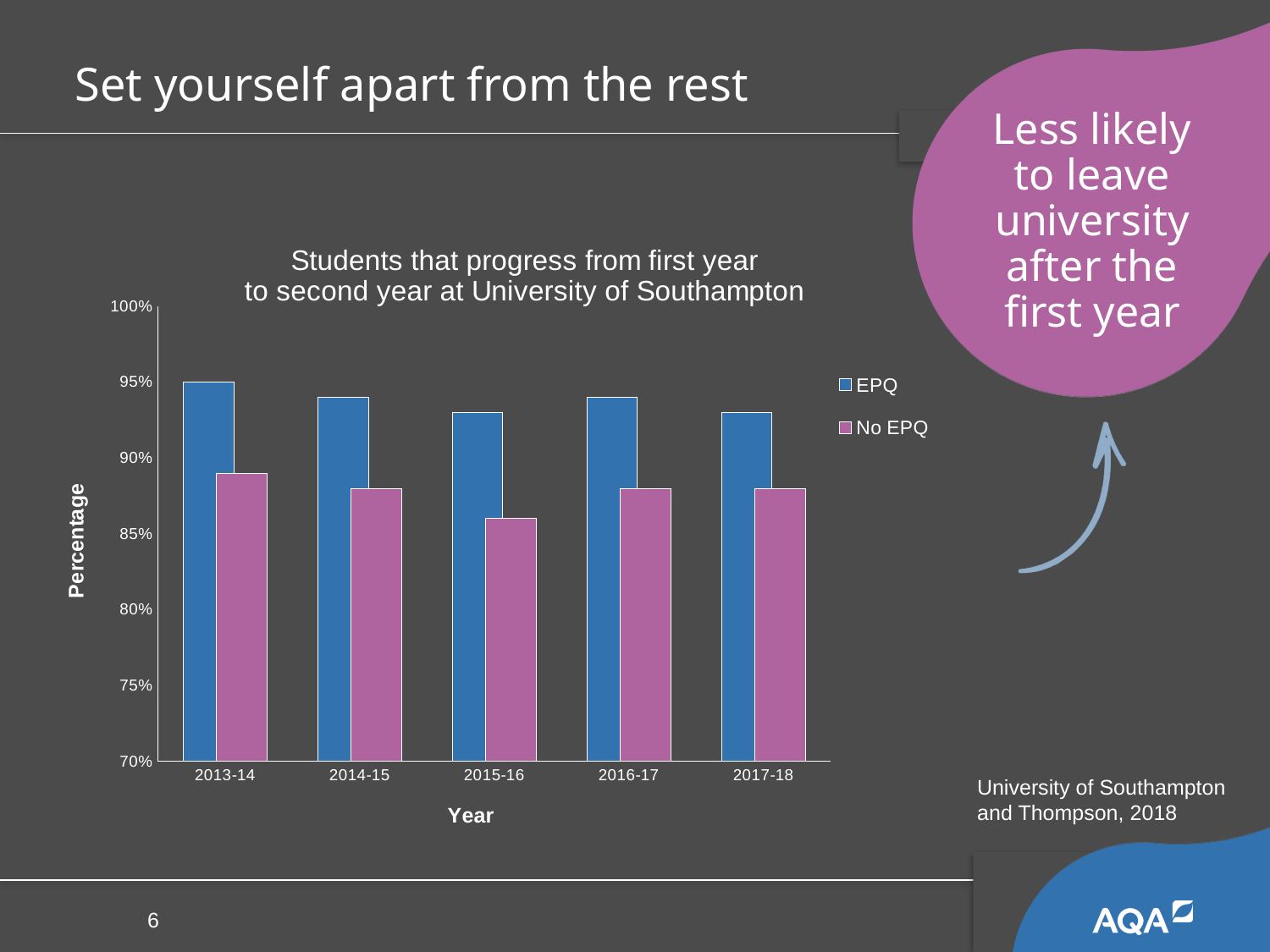
Is the value for EPQ in 2017-18 greater or less than 90%? greater Is the value for No EPQ in 2015-16 greater or less than 90%? less How many series does the chart's legend list? 2 How many years are shown on the x axis of the chart? 5 In 2015-16, which is larger: the value for EPQ or the value for No EPQ? EPQ Is the value for No EPQ in 2013-14 greater or less than 85%? greater What are the two series named in the chart's legend? EPQ and No EPQ In which year is the No EPQ value lowest? 2015-16 What kind of chart is shown on the slide? bar chart What is the title of the chart? Students that progress from first year to second year at University of Southampton In which year is the EPQ value highest? 2013-14